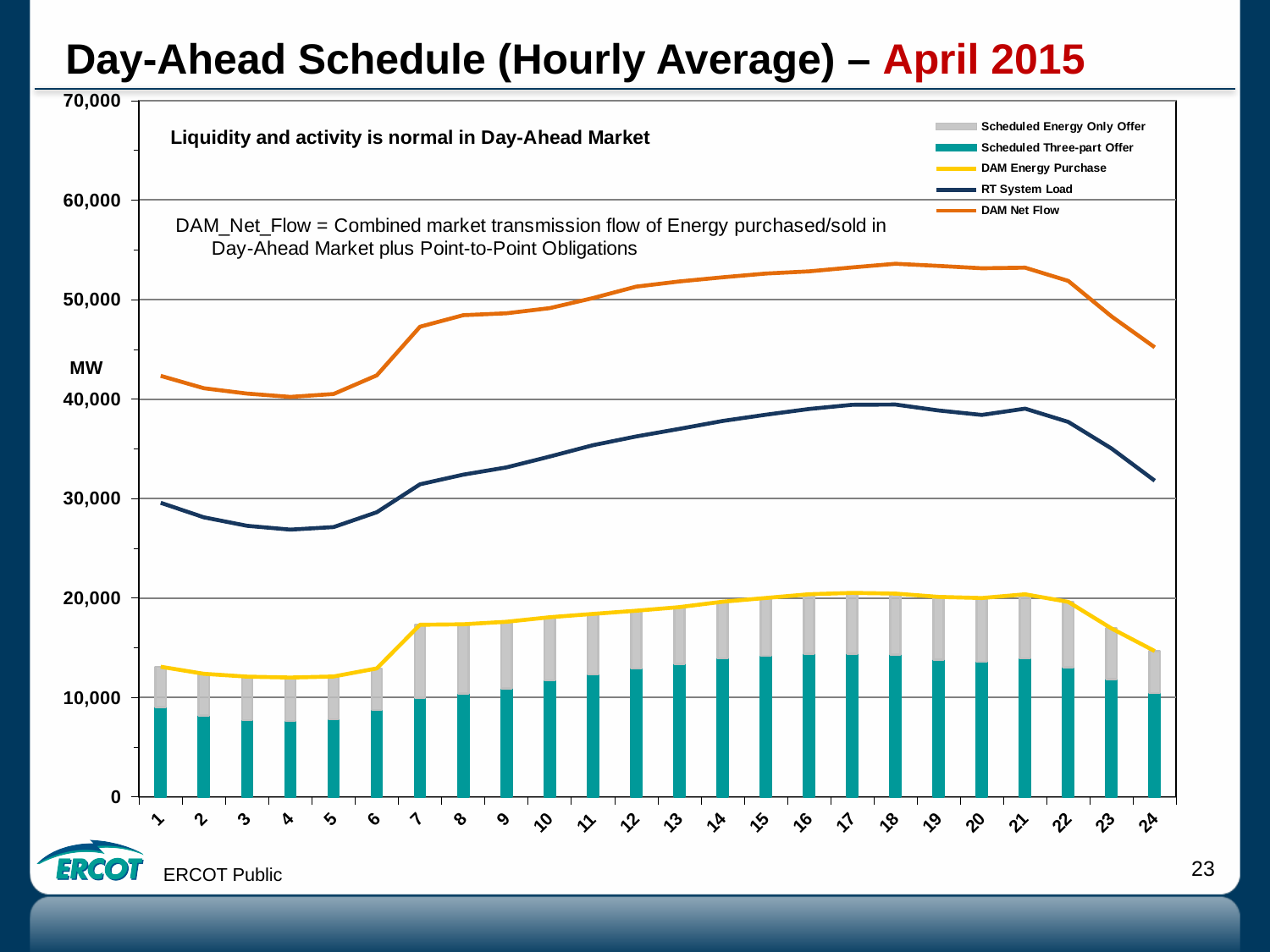
Is the RT System Load value at hour 24 greater or less than 30,000? greater What kind of chart is this? Combined bar and line chart Does RT System Load rise or fall from hour 21 to hour 24? Fall Is the DAM Net Flow value at hour 1 greater or less than 40,000? greater What unit is shown on the y axis? MW Is the RT System Load value at hour 4 greater or less than 30,000? less Which is larger for Scheduled Three-part Offer, hour 4 or hour 17? Hour 17 How many hours are shown along the x axis? 24 How many series does the legend list? 5 Does DAM Net Flow rise or fall from hour 6 to hour 18? Rise Which is larger at hour 12, DAM Net Flow or RT System Load? DAM Net Flow